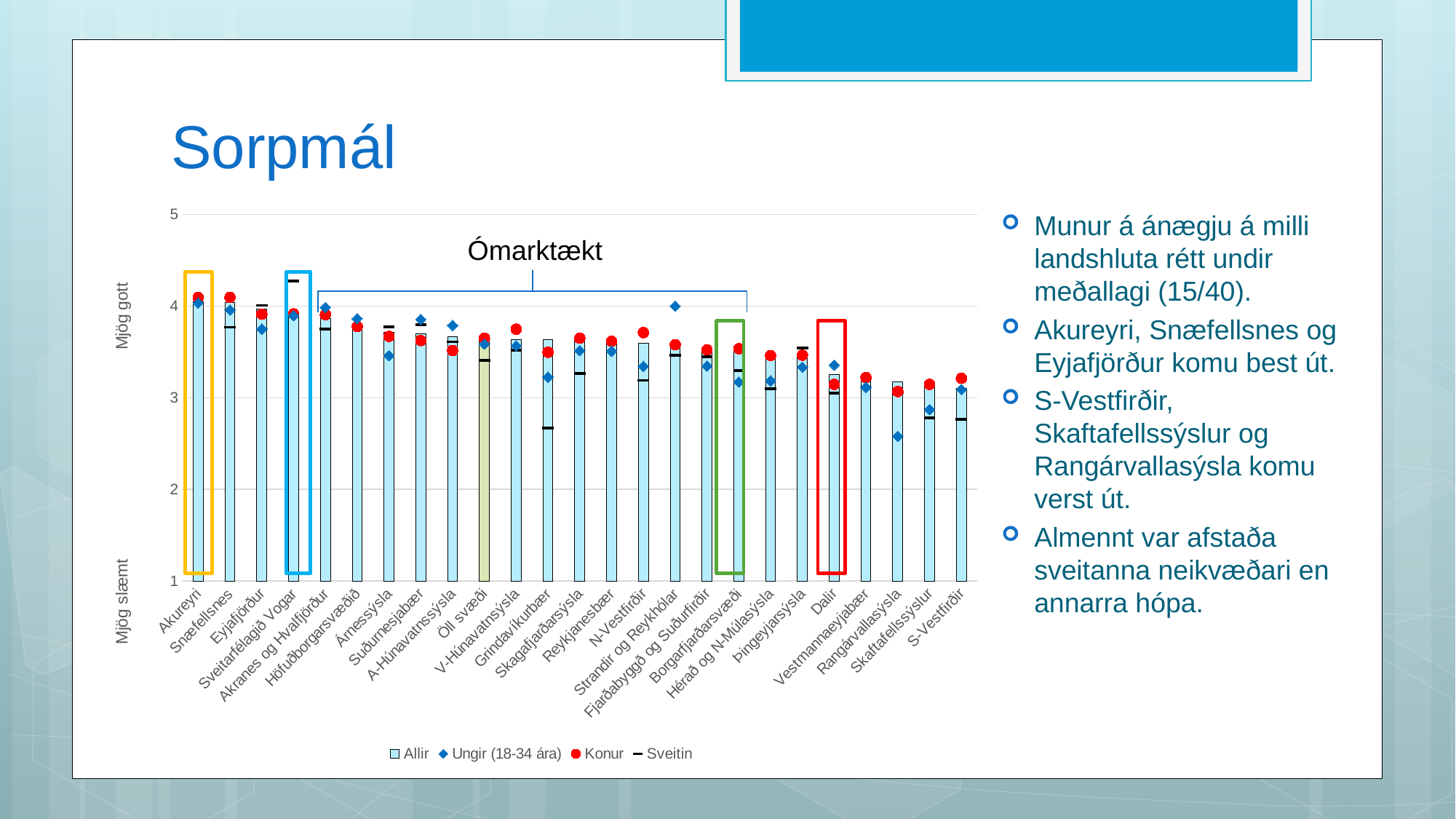
What kind of chart is shown on the slide? bar chart How many series does the chart legend list? 4 Which series in the chart is shown with red circle markers? Konur Is the Allir value for Akureyri greater or less than 3? greater How many categories are shown along the x axis of the chart? 25 Is the Allir value for S-Vestfirðir greater or less than 4? less Do the Allir bar values generally rise or fall from left to right along the x axis? fall What annotation text is written above the bracket spanning the middle categories of the chart? Ómarktækt Which category has the highest Allir bar in the chart? Akureyri Which has the larger Allir value, Akureyri or S-Vestfirðir? Akureyri Is the Sveitin value for Grindavíkurbær greater or less than 3? less